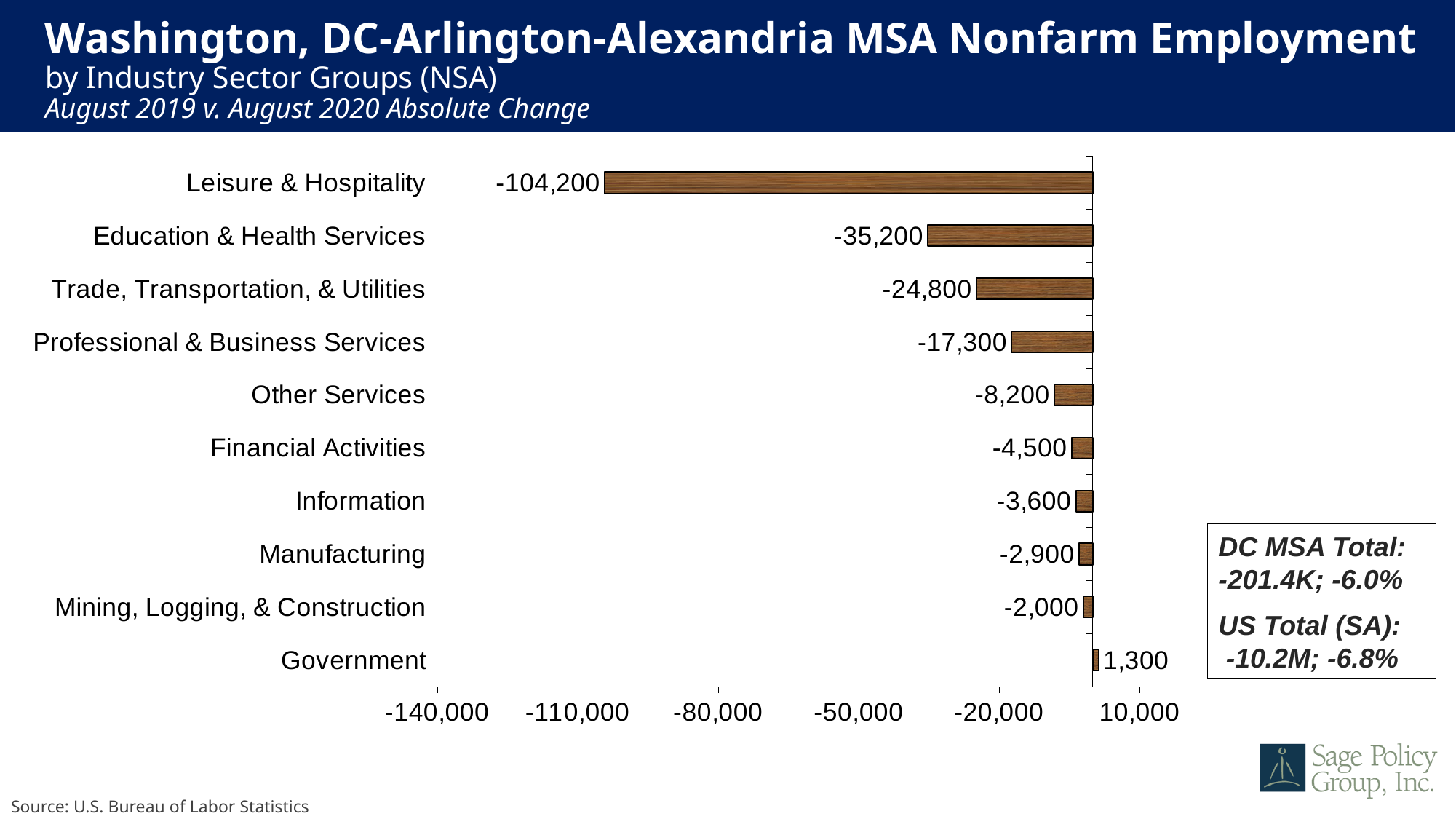
What is the absolute change in employment for Leisure & Hospitality? -104,200 What is the source cited for the chart data? U.S. Bureau of Labor Statistics What is the absolute change in employment for Government? 1,300 What is the absolute change in employment for Financial Activities? -4,500 What is the DC MSA total change shown in the text box? -201.4K; -6.0% Which sector had a larger decline, Professional & Business Services or Other Services? Professional & Business Services How many industry sector groups are shown in the chart? 10 What is the absolute change in employment for Education & Health Services? -35,200 Which industry sector group is the only one with a positive change? Government Which industry sector group has the largest employment decline? Leisure & Hospitality What is the difference between the changes for Education & Health Services and Trade, Transportation, & Utilities? 10,400 What type of chart is shown on the slide? Bar chart